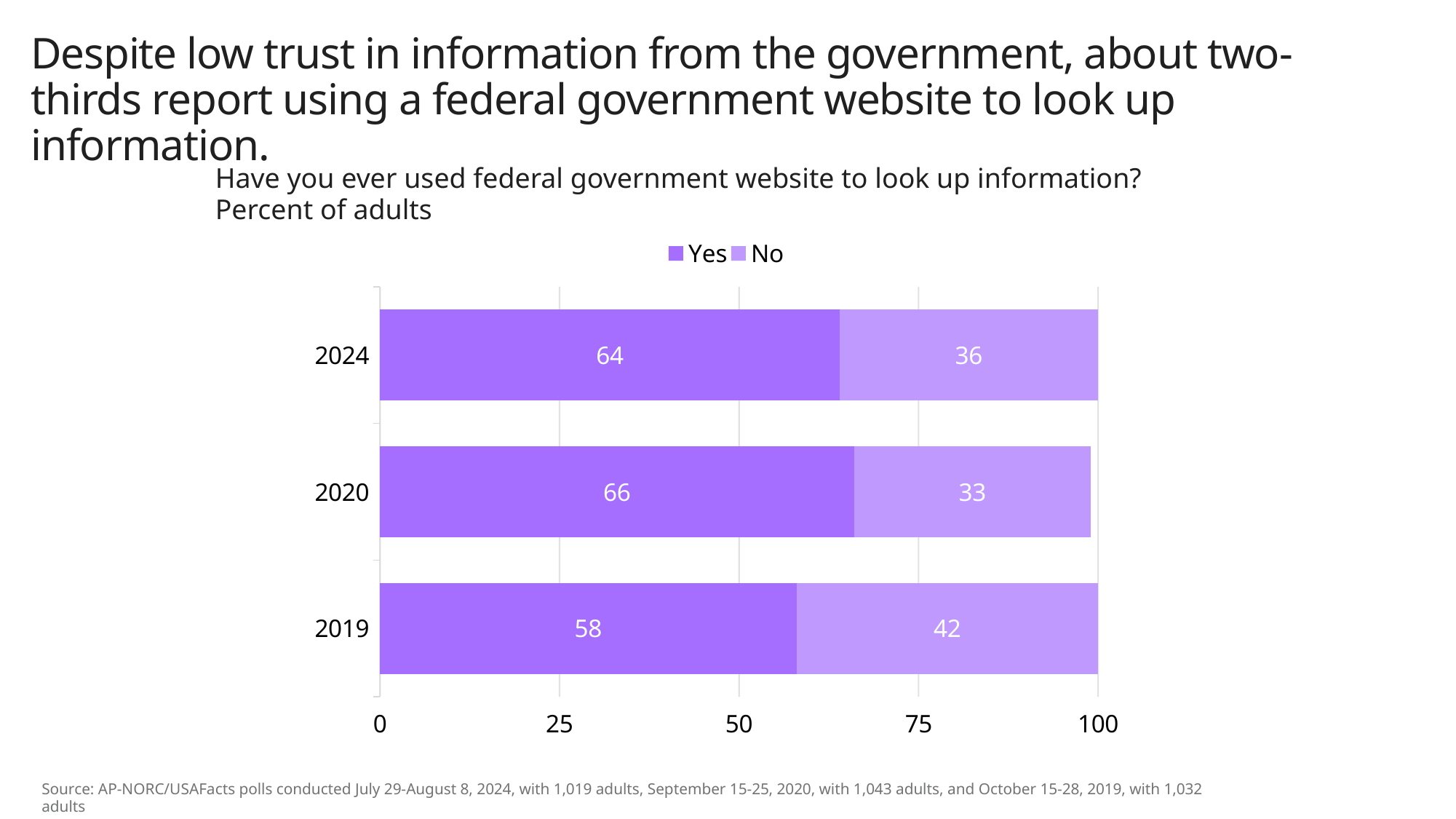
What is the Yes value for 2020? 66 What is the total of the 2020 bar (Yes plus No)? 99 How many years are shown on the chart? 3 What kind of chart is shown? Stacked bar chart Is the Yes value for 2019 greater or less than 50? greater What is the difference between the Yes values for 2020 and 2019? 8 Which year has the highest Yes value? 2020 Is the No value larger in 2019 or in 2024? 2019 What percent of adults answered Yes in 2024? 64 How many series does the legend list? 2 Which year has the lowest Yes value? 2019 What percent of adults answered No in 2019? 42